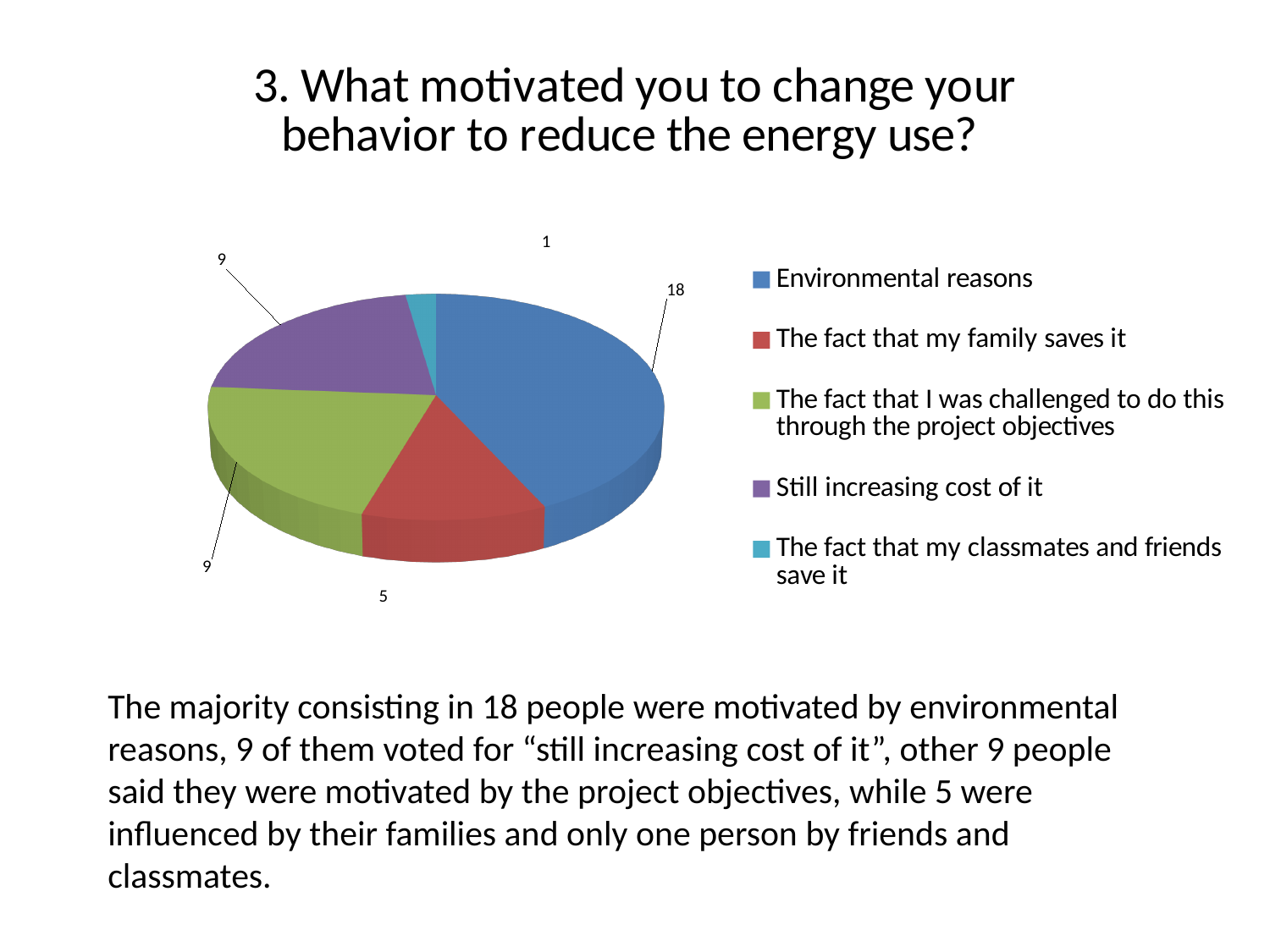
What is the value for 'The fact that my classmates and friends save it'? 1 Which is larger: the value for 'Still increasing cost of it' or the value for 'The fact that my family saves it'? Still increasing cost of it How many categories does the pie chart have? 5 What type of chart is shown on the slide? pie chart How many people were motivated by environmental reasons? 18 What is the total of all the values shown in the pie chart? 42 What is the value for 'The fact that my family saves it'? 5 What colour is the slice for 'Environmental reasons'? blue What is the value for 'Still increasing cost of it'? 9 Which category has the largest slice of the pie? Environmental reasons Which category has the smallest slice of the pie? The fact that my classmates and friends save it What is the difference between the value for 'Environmental reasons' and the value for 'The fact that my family saves it'? 13